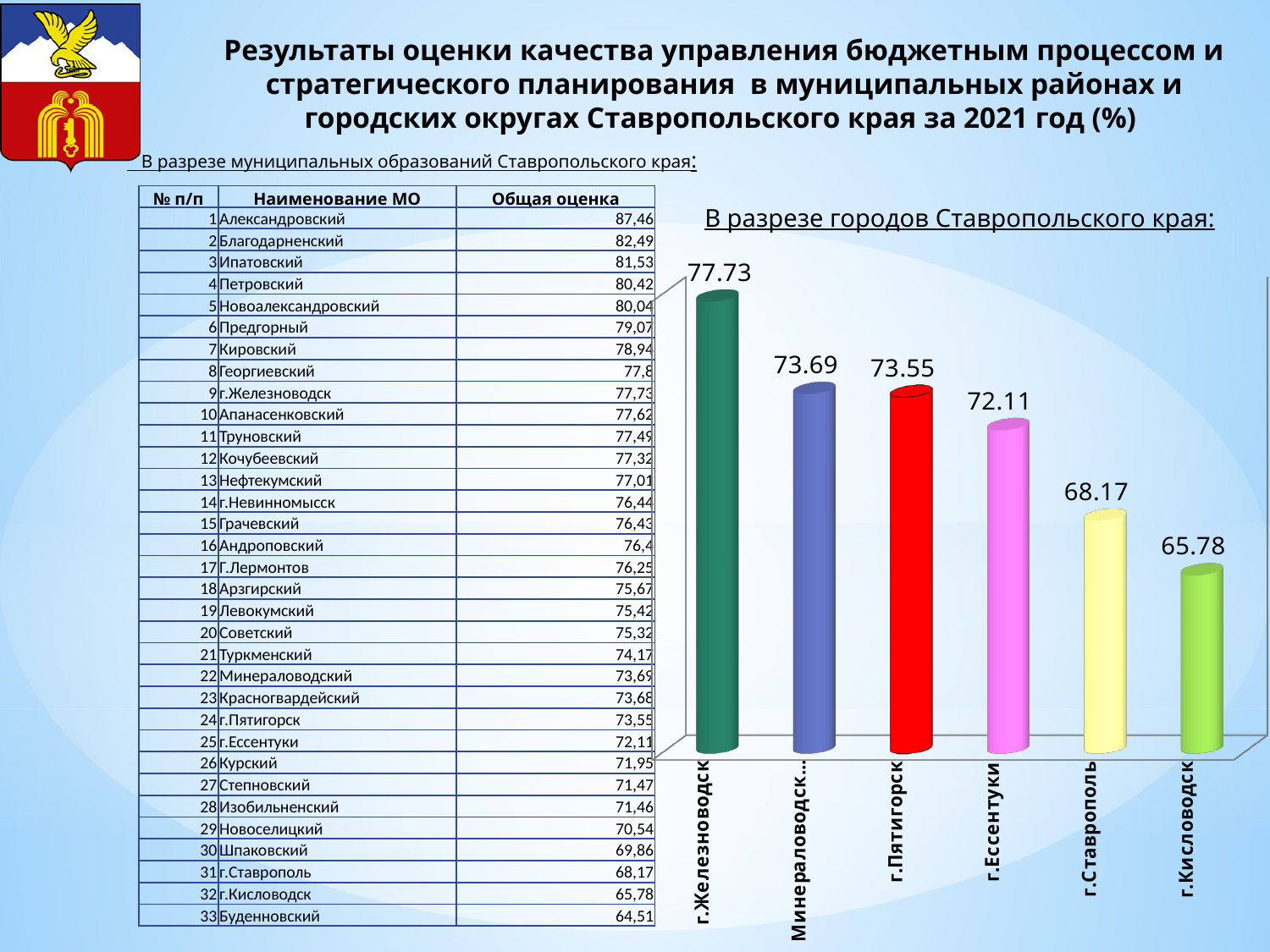
What is the difference between the values for г.Ессентуки and г.Ставрополь? 3.94 What is the difference between the values for г.Железноводск and г.Кисловодск? 11.95 What is the value shown for г.Пятигорск in the chart? 73.55 How many cities are shown as bars in the chart? 6 What is the value shown for г.Ессентуки in the chart? 72.11 Which city has the lowest value in the chart? г.Кисловодск What is the value shown for г.Кисловодск in the chart? 65.78 Which city has the highest value in the chart? г.Железноводск What is the value shown for г.Железноводск in the chart? 77.73 What kind of chart is shown on the slide? bar chart Which has a larger value, г.Ставрополь or г.Ессентуки? г.Ессентуки Do the values rise or fall from left to right across the chart? fall